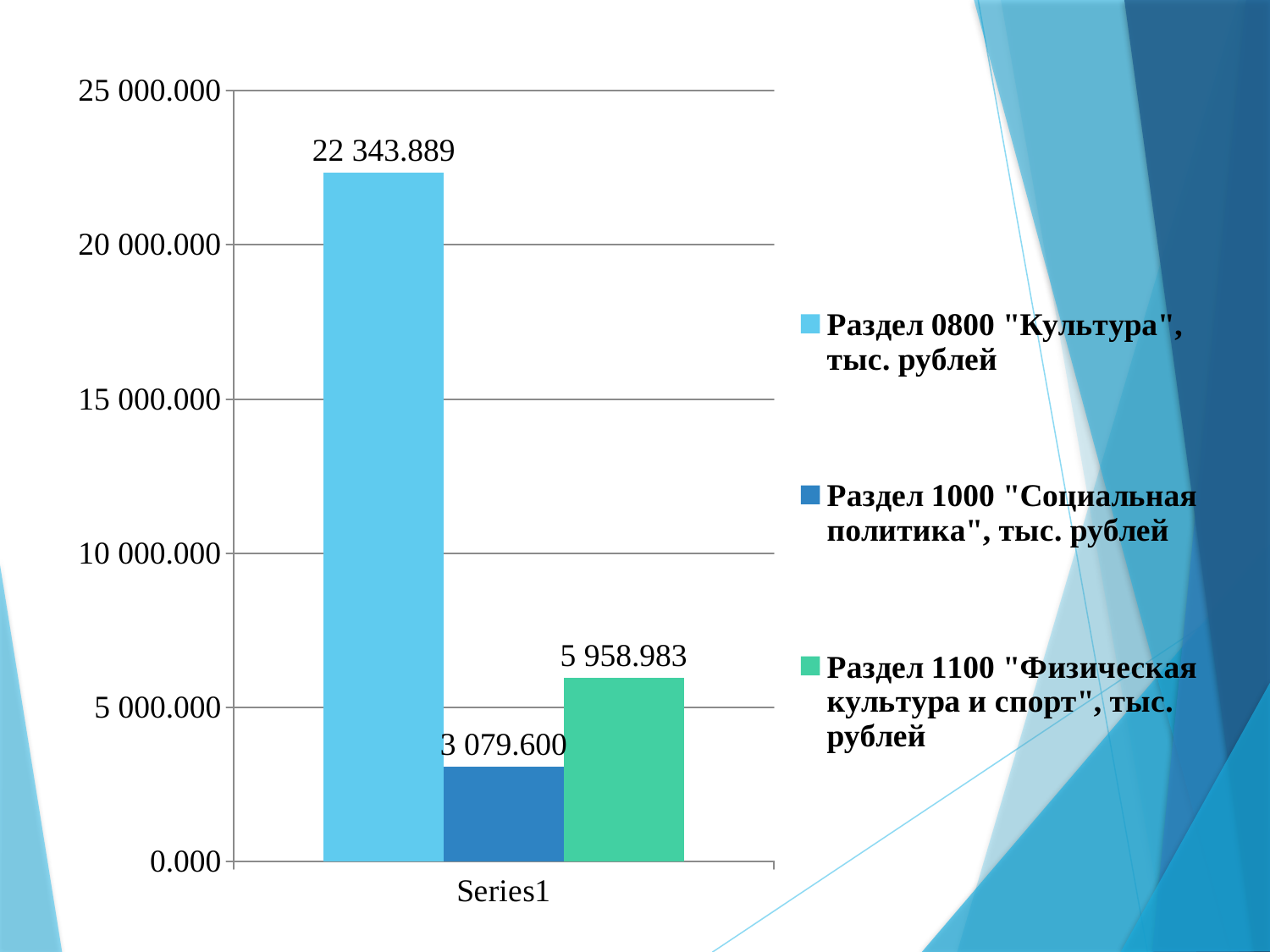
What colour is the bar for Раздел 1100 "Физическая культура и спорт"? green What is the difference between the values for Раздел 0800 "Культура" and Раздел 1000 "Социальная политика"? 19 264.289 What is the value for Раздел 0800 "Культура", тыс. рублей? 22 343.889 How many series does the legend list? 3 What is the value for Раздел 1000 "Социальная политика", тыс. рублей? 3 079.600 What kind of chart is shown on the slide? bar chart Is the value for Раздел 0800 "Культура" greater or less than 20 000.000? greater What is the value for Раздел 1100 "Физическая культура и спорт", тыс. рублей? 5 958.983 What is the difference between the values for Раздел 1100 "Физическая культура и спорт" and Раздел 1000 "Социальная политика"? 2 879.383 Which is larger, the value for Раздел 1100 "Физическая культура и спорт" or the value for Раздел 1000 "Социальная политика"? Раздел 1100 "Физическая культура и спорт" Which section has the highest value? Раздел 0800 "Культура" Which section has the lowest value? Раздел 1000 "Социальная политика"